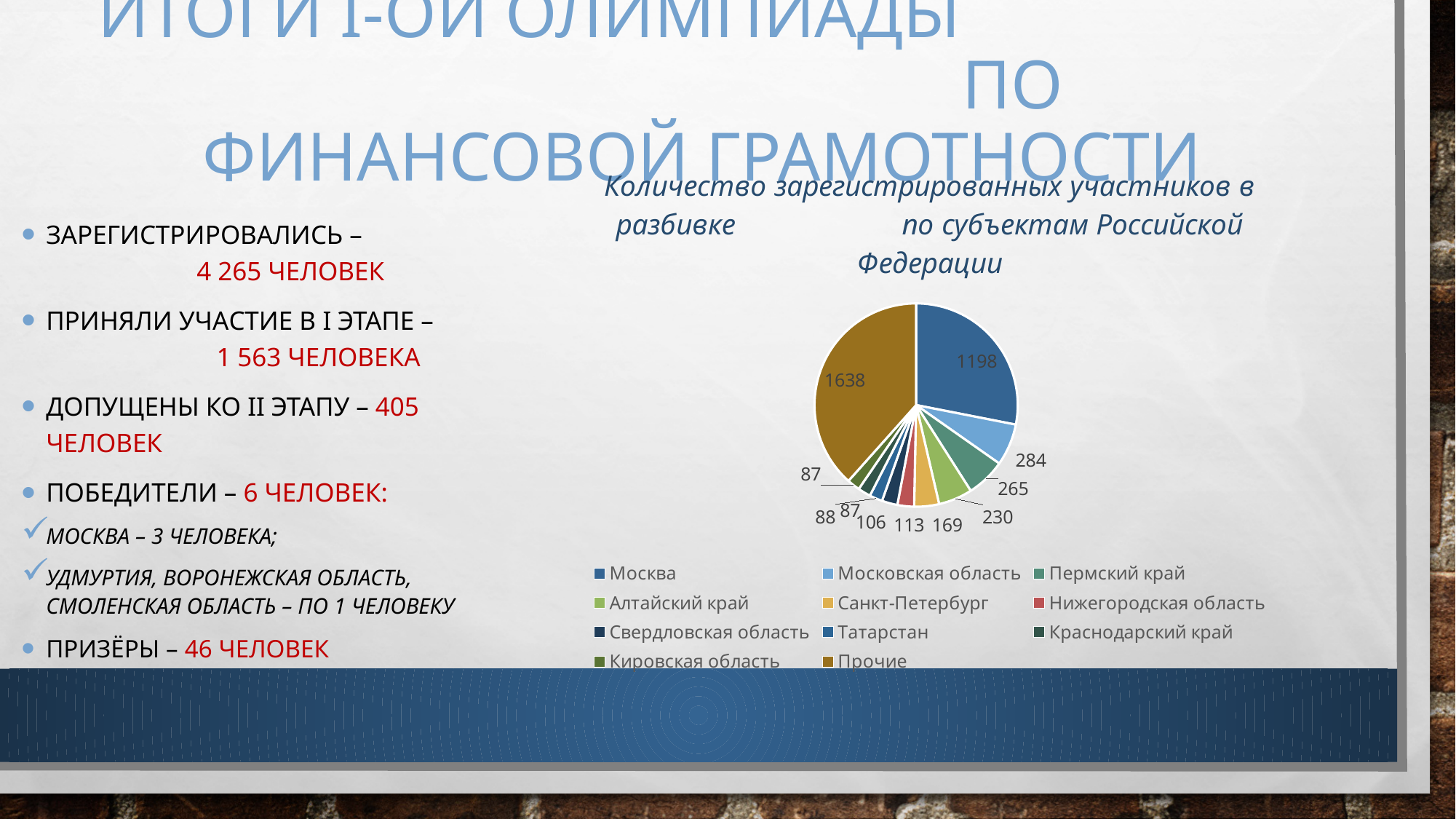
How many categories does the legend of the pie chart list? 11 What is the value for Санкт-Петербург in the pie chart? 169 Which category has the largest slice in the pie chart? Прочие What is the value for Москва in the pie chart? 1198 What is the value for Московская область in the pie chart? 284 What is the difference between the values for Прочие and Москва? 440 What kind of chart is shown on the slide? pie chart What is the difference between the values for Москва and Московская область? 914 Which is larger, the value for Пермский край or the value for Алтайский край? Пермский край What is the value for Прочие in the pie chart? 1638 What is the title of the pie chart? Количество зарегистрированных участников в разбивке по субъектам Российской Федерации What is the value for Пермский край in the pie chart? 265